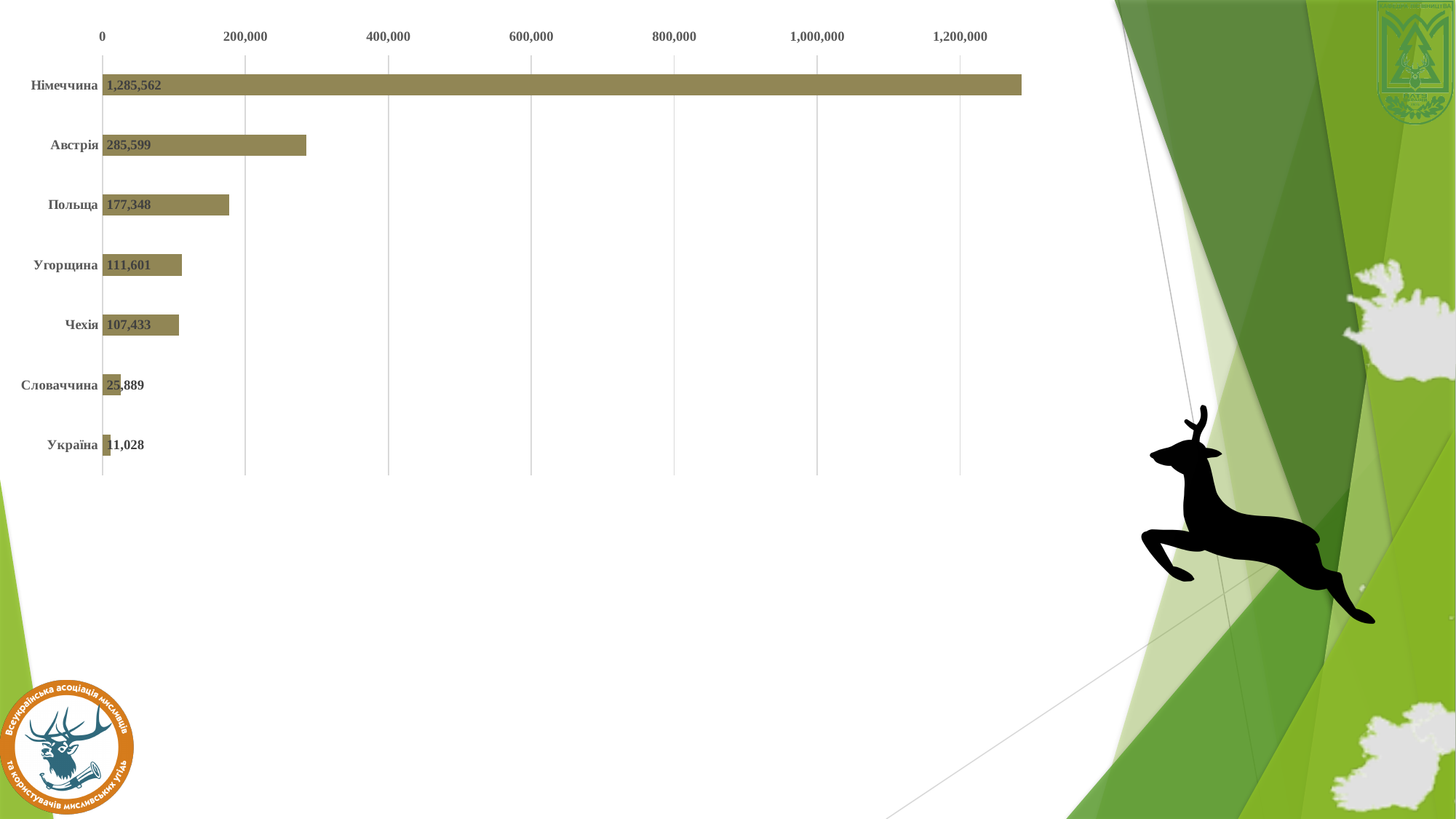
How many countries are shown in the chart? 7 What is the value for Чехія? 107,433 Is the value for Австрія greater or less than 200,000? greater Which country has the lowest value? Україна What is the difference between the values for Польща and Угорщина? 65,747 Which has a larger value, Австрія or Польща? Австрія What is the value for Німеччина? 1,285,562 What is the difference between the values for Німеччина and Австрія? 999,963 What is the value for Україна? 11,028 What is the value for Австрія? 285,599 What kind of chart is shown on the slide? bar chart Which country has the highest value? Німеччина